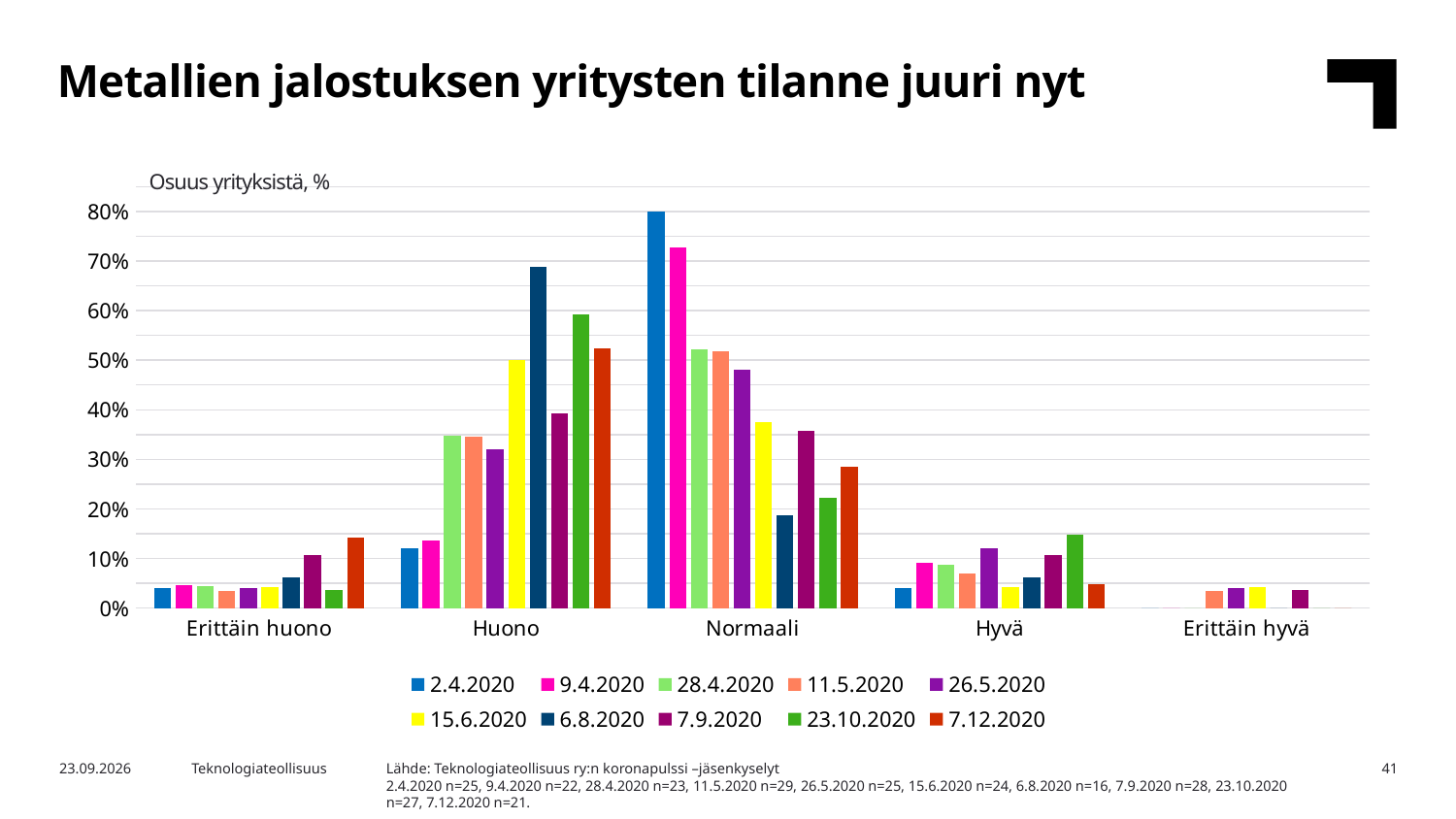
Is the value for Huono in the 6.8.2020 series greater or less than 60%? greater For Normaali, which is larger: the 2.4.2020 value or the 9.4.2020 value? 2.4.2020 Is the value for Normaali in the 6.8.2020 series greater or less than 30%? less Is the value for Erittäin huono in the 7.12.2020 series greater or less than 10%? greater How many series does the legend list? 10 What type of chart is shown on the slide? bar chart Within the Huono category, which series has the highest bar? 6.8.2020 Which category has the highest value for the 2.4.2020 series? Normaali For Huono, which is larger: the 6.8.2020 value or the 23.10.2020 value? 6.8.2020 How many categories are shown on the x axis? 5 What is the label shown above the y axis? Osuus yrityksistä, %